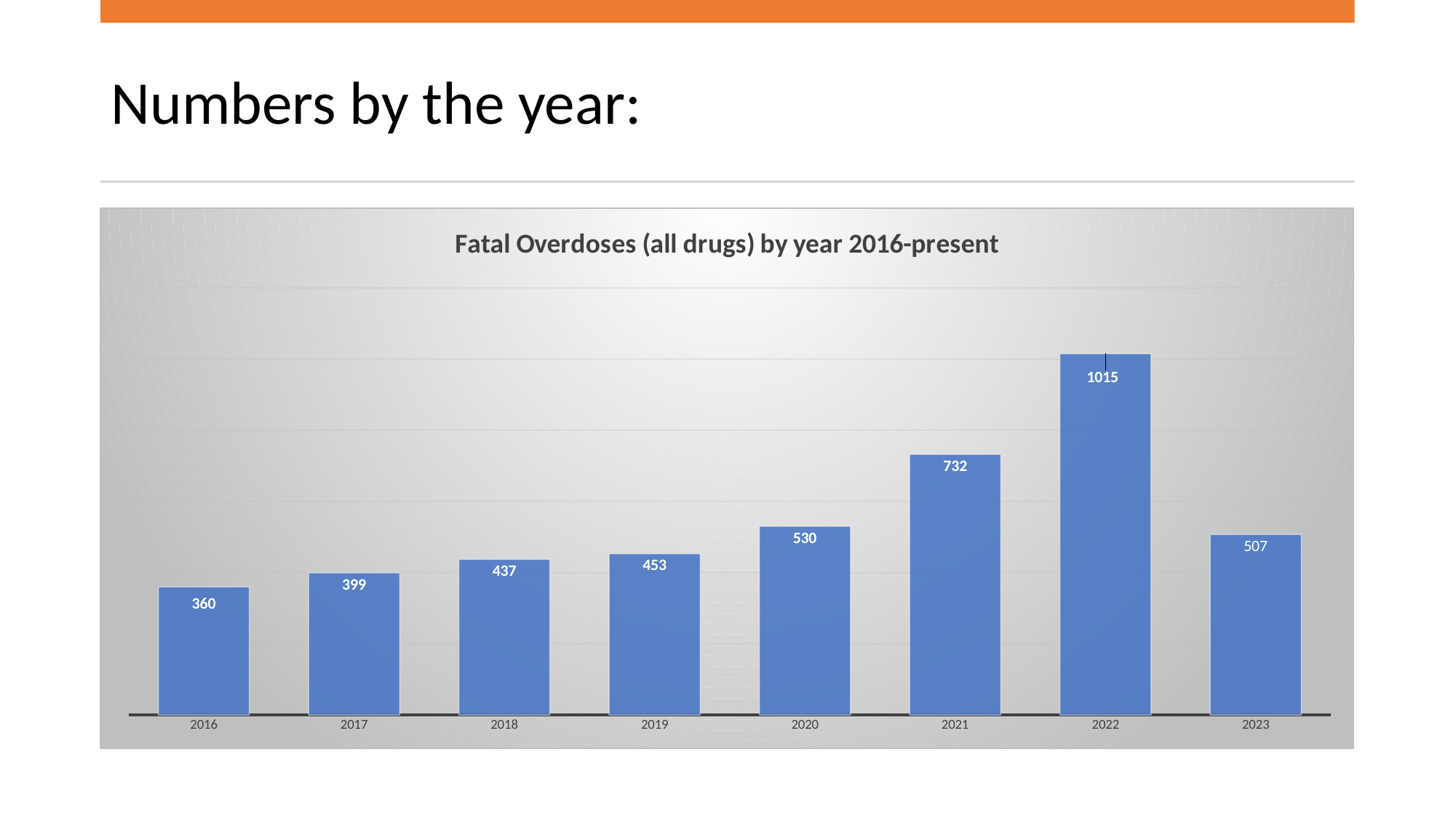
What kind of chart is this? Bar chart Which year has the lowest value? 2016 How many years are shown on the chart? 8 What is the title of the chart? Fatal Overdoses (all drugs) by year 2016-present Which year has the highest value? 2022 What is the value for 2020? 530 What is the difference between the values for 2019 and 2018? 16 What is the value for 2023? 507 What is the value for 2016? 360 What is the difference between the values for 2022 and 2021? 283 Do the values rise or fall from 2016 to 2022? Rise Which is larger, the value for 2023 or the value for 2020? 2020